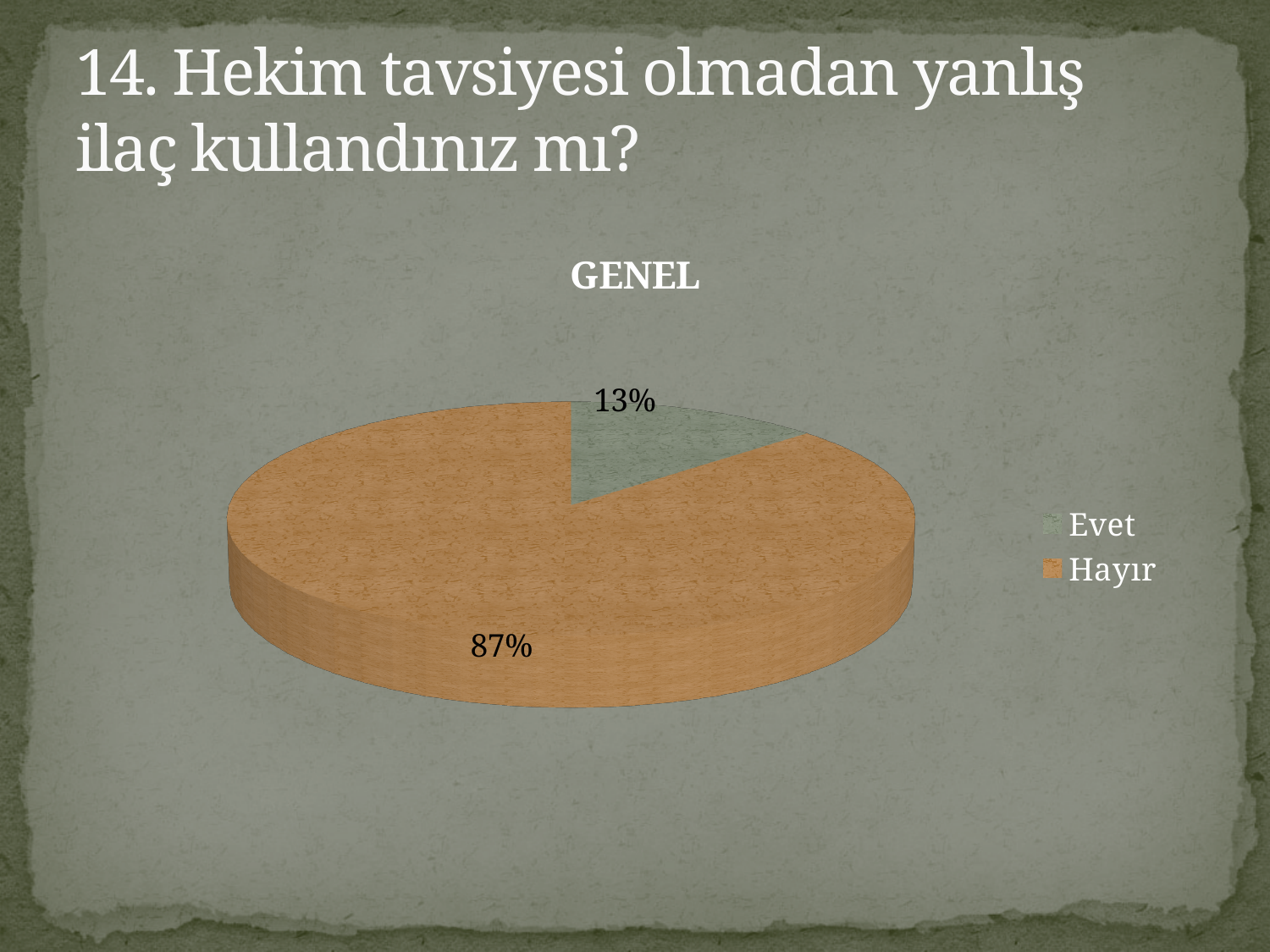
Which category has the largest slice of the pie? Hayır What kind of chart is shown on the slide? pie chart Which category has the smallest slice of the pie? Evet How many entries does the legend list? 2 What share of the pie does Hayır represent? 87% Which is larger, the Evet slice or the Hayır slice? Hayır How many categories does the pie chart have? 2 What colour is the Hayır slice? orange/brown What share of the pie does Evet represent? 13% What is the difference in percentage points between Hayır and Evet? 74 What is the title of the chart? GENEL